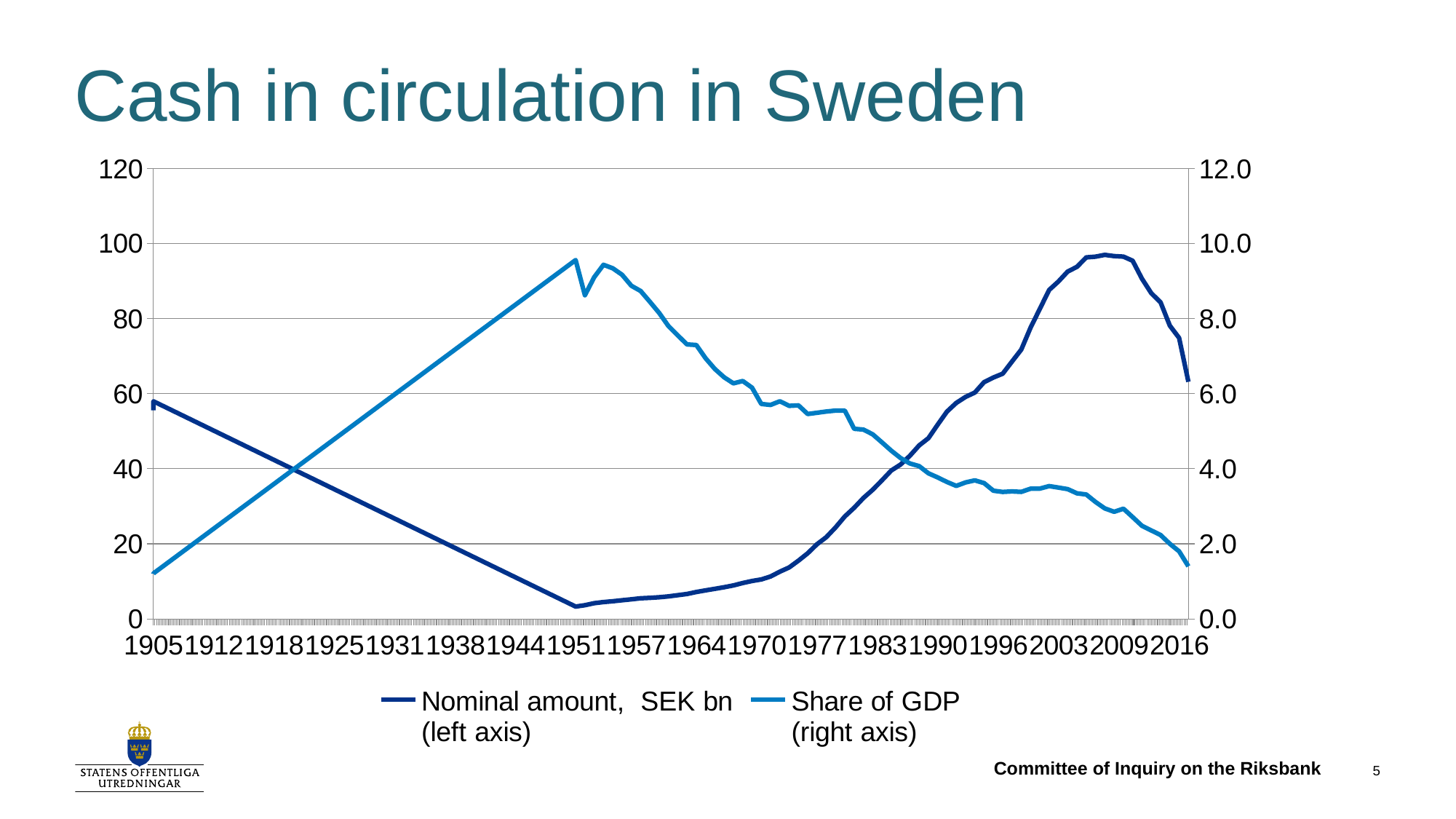
Is the Share of GDP value in 1905 greater or less than 2.0? less What is the title of the chart? Cash in circulation in Sweden Around which year on the x axis does the Nominal amount, SEK bn series reach its lowest value? 1951 What type of chart is shown on the slide? line chart How many series does the legend list? 2 Is the Nominal amount, SEK bn value in 1951 greater or less than 20? less Is the Share of GDP value in 1951 greater or less than 8.0? greater Which axis is the Share of GDP series plotted against? right axis Does the Nominal amount, SEK bn series rise or fall between 1905 and 1951? fall Does the Share of GDP series rise or fall between 1951 and 2016? fall